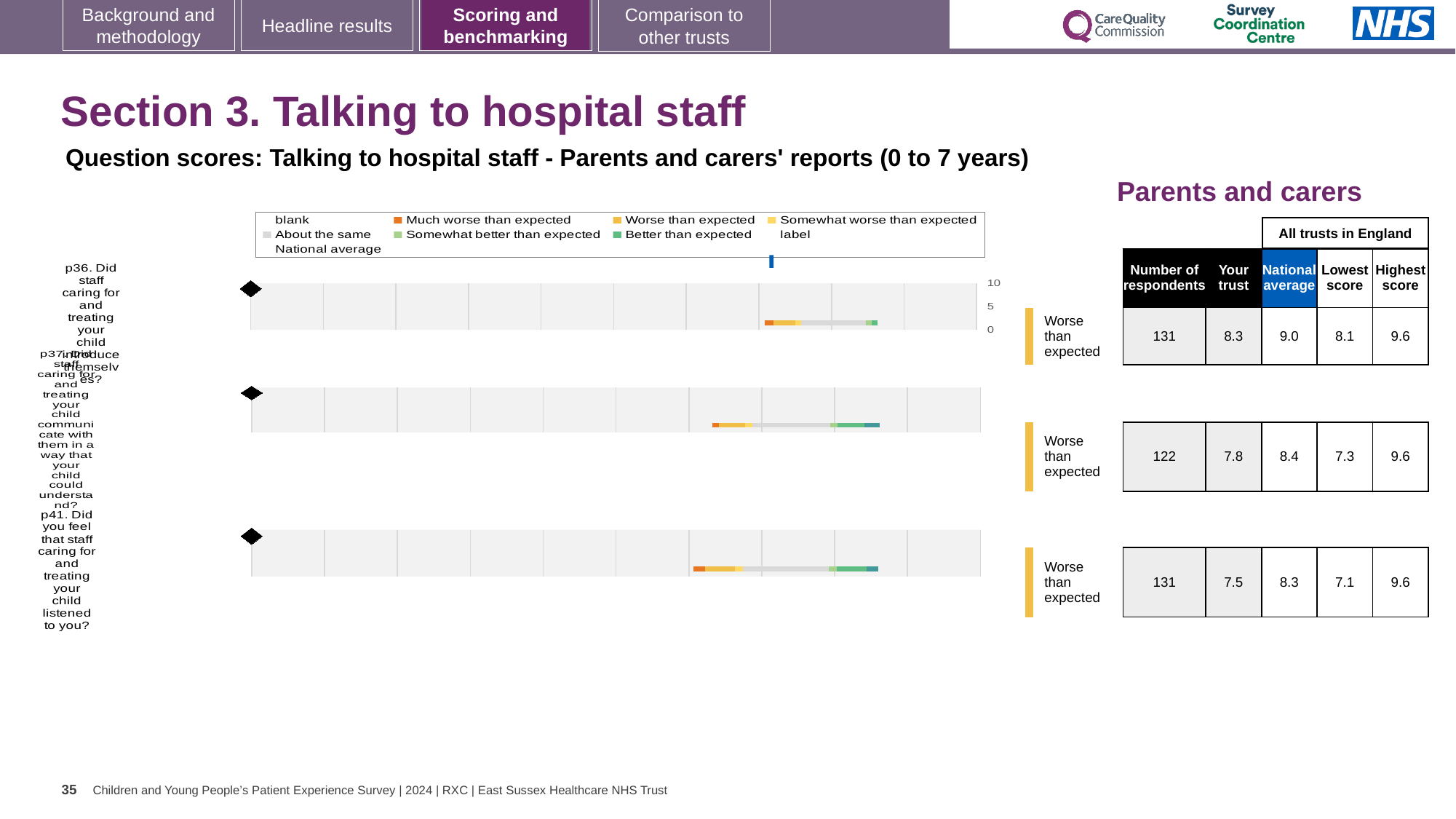
For the p36 chart, what is the highest score among all trusts in England? 9.6 Which question has the lowest 'Your trust' score? p41 For the p36 chart, is the 'Your trust' score higher or lower than the national average? lower In the chart legend, which category is shown in orange? Much worse than expected For the p41 chart, how many respondents are there? 131 What kind of chart is used to show the question scores on this slide? bar chart For the p36 chart, what is the 'Your trust' score? 8.3 For the p37 chart, what is the national average score? 8.4 What benchmark category is shown next to the p37 chart? Worse than expected In the chart legend, which category is shown in dark green? Better than expected How many question charts are shown on the slide? 3 For the p41 chart, what is the difference between the national average and the 'Your trust' score? 0.8